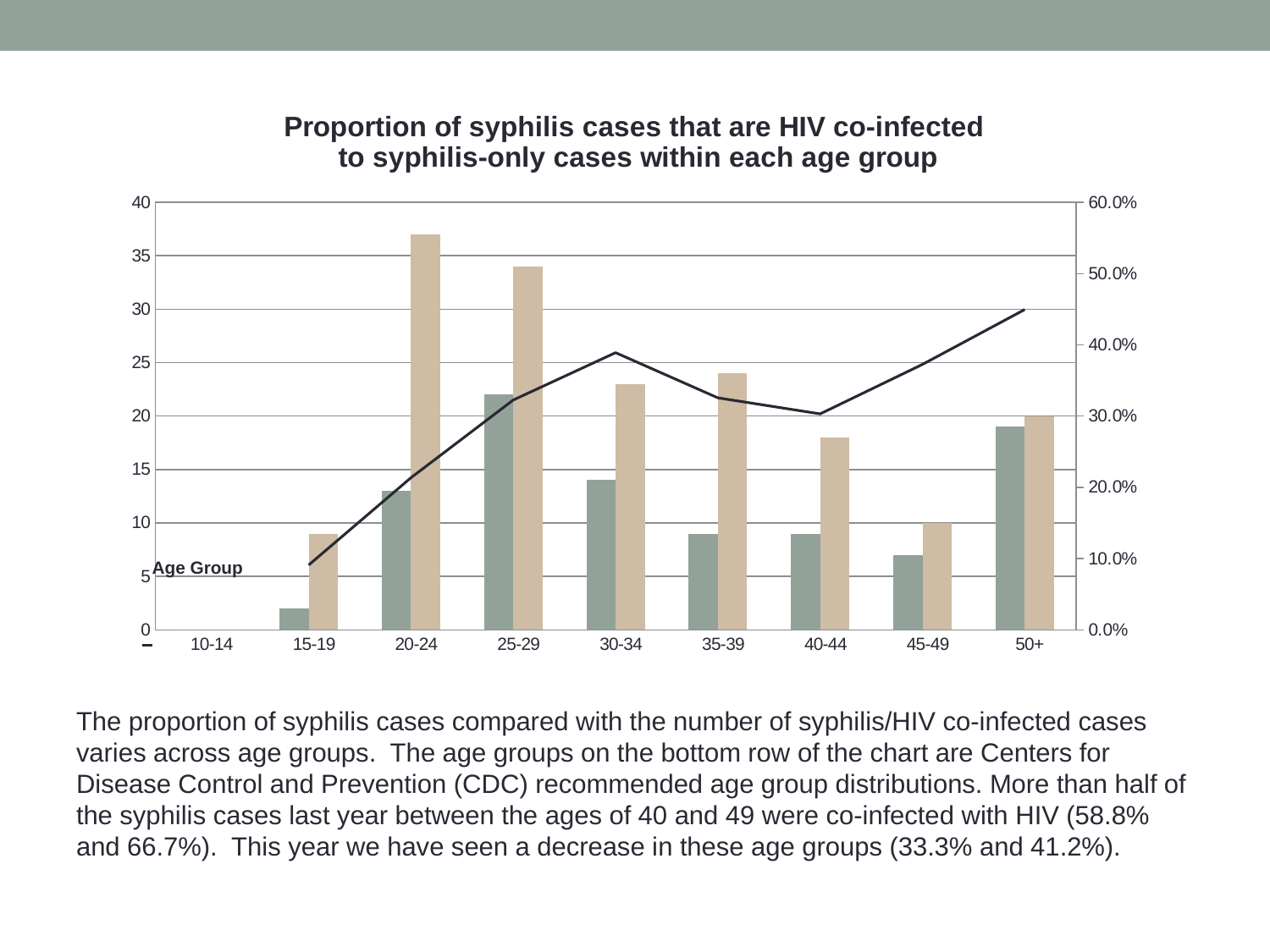
How many age groups are shown on the x axis of the chart? 9 What is the highest value shown on the right-hand axis of the chart? 60.0% What kind of chart is shown on the slide? bar chart with a line overlay Which tan bar is taller, 25-29 or 30-34? 25-29 Is the line value for the 15-19 age group greater or less than 20.0% on the right axis? less Is the line value for the 50+ age group greater or less than 40.0% on the right axis? greater Is the green bar for the 15-19 age group greater or less than 5 on the left axis? less Does the line rise or fall from the 15-19 age group to the 30-34 age group? rise Which age group has the tallest green bar? 25-29 Which age group has the tallest tan bar? 20-24 Which green bar is taller, 45-49 or 50+? 50+